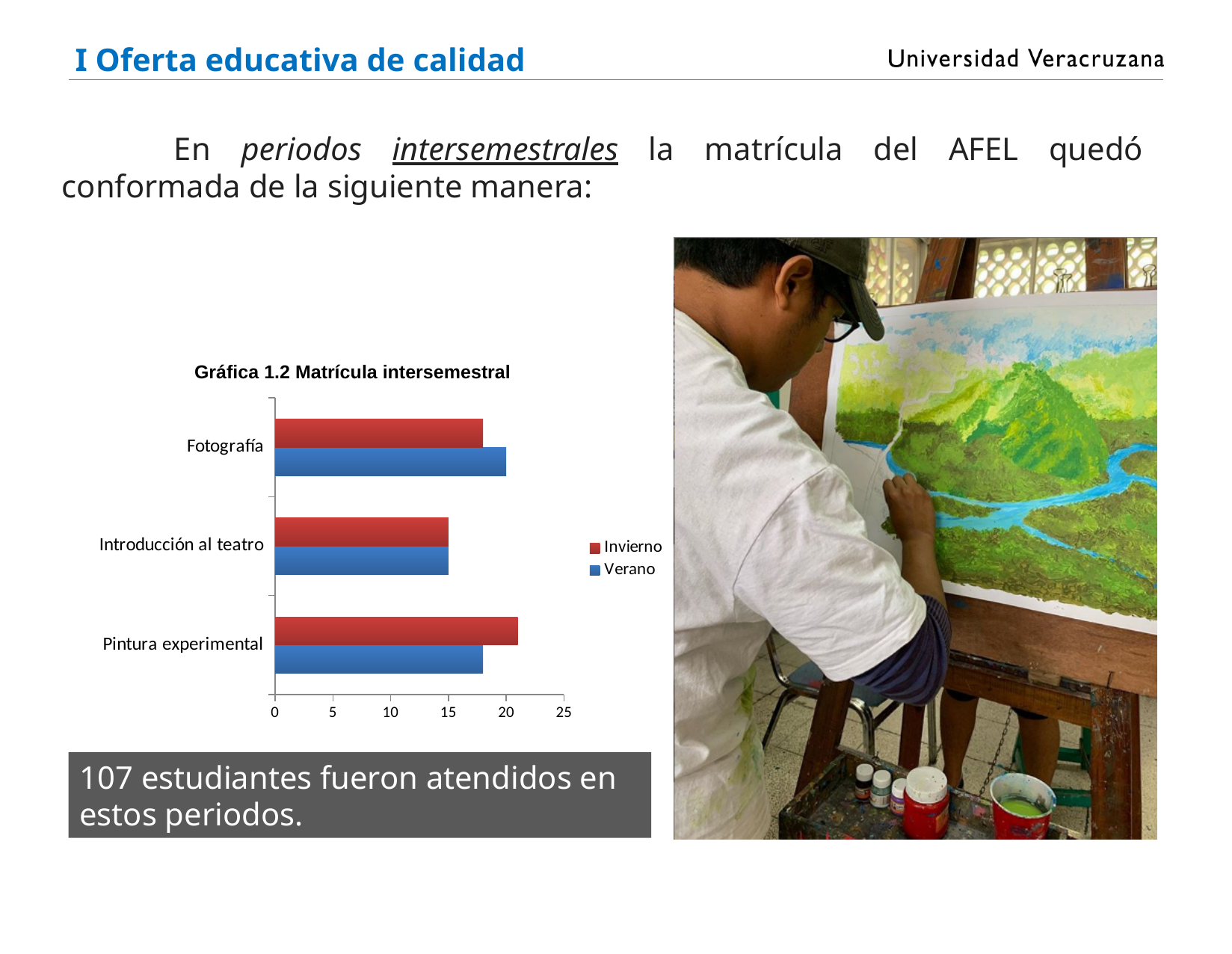
For Fotografía, which series has the larger value, Invierno or Verano? Verano Is the Verano value for Pintura experimental greater or less than 20? less Which category has the highest Verano value? Fotografía What kind of chart is shown on the slide? Bar chart How many categories are shown on the chart? 3 Which colour represents the Invierno series in the chart? Red How many series does the chart legend list? 2 What is the title of the chart? Gráfica 1.2 Matrícula intersemestral Is the Invierno value for Pintura experimental greater or less than 20? greater Which category has the highest Invierno value? Pintura experimental Which category has the lowest Invierno value? Introducción al teatro For Pintura experimental, which series has the larger value, Invierno or Verano? Invierno